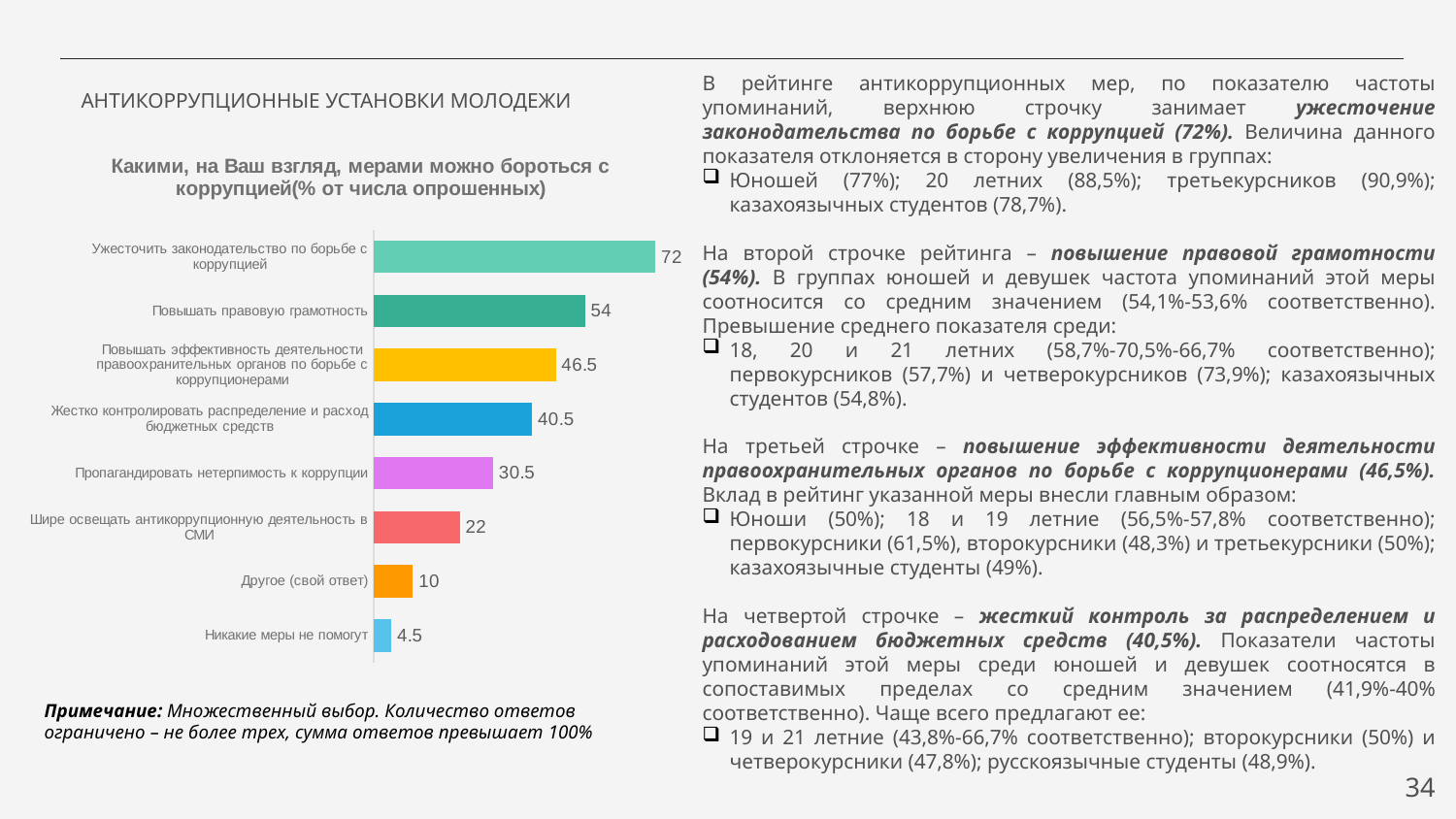
What is the value for "Жестко контролировать распределение и расход бюджетных средств"? 40.5 What is the difference between the values for "Другое (свой ответ)" and "Никакие меры не помогут"? 5.5 How many categories are shown in the chart? 8 What is the value for "Никакие меры не помогут"? 4.5 What is the difference between the values for "Повышать правовую грамотность" and "Повышать эффективность деятельности правоохранительных органов по борьбе с коррупционерами"? 7.5 What kind of chart is shown on the slide? Bar chart What is the value for "Ужесточить законодательство по борьбе с коррупцией"? 72 What is the title of the chart? Какими, на Ваш взгляд, мерами можно бороться с коррупцией(% от числа опрошенных) Which category has the highest value? Ужесточить законодательство по борьбе с коррупцией What is the value for "Повышать правовую грамотность"? 54 Which category has the lowest value? Никакие меры не помогут Which is larger: the value for "Пропагандировать нетерпимость к коррупции" or the value for "Шире освещать антикоррупционную деятельность в СМИ"? Пропагандировать нетерпимость к коррупции